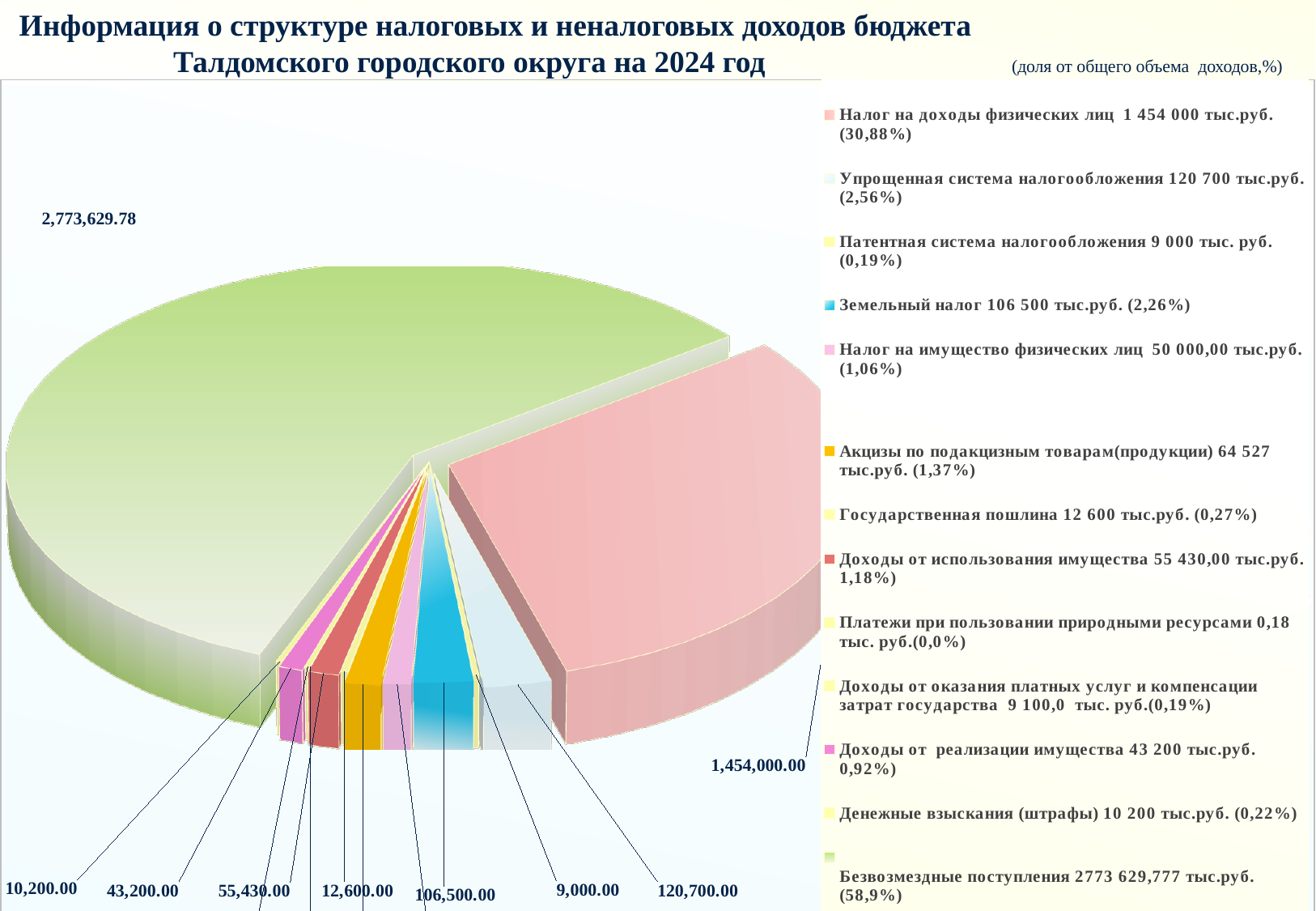
Which is larger: the value for Земельный налог or the value for Упрощенная система налогообложения? Упрощенная система налогообложения What value is labelled on the slice for Безвозмездные поступления? 2,773,629.78 What kind of chart is shown on the slide? pie chart What value is labelled on the slice for Денежные взыскания (штрафы)? 10,200.00 According to the legend, what share of total revenue does Безвозмездные поступления make up? 58,9% What value is labelled on the slice for Государственная пошлина? 12,600.00 What value is labelled on the slice for Налог на доходы физических лиц? 1,454,000.00 According to the legend, what share of total revenue does Налог на доходы физических лиц make up? 30,88% Which category has the largest slice of the pie? Безвозмездные поступления What year does the chart title say the budget revenue structure refers to? 2024 How many categories does the legend list? 13 What is the difference between the labelled values for Упрощенная система налогообложения (120,700.00) and Земельный налог (106,500.00)? 14,200.00